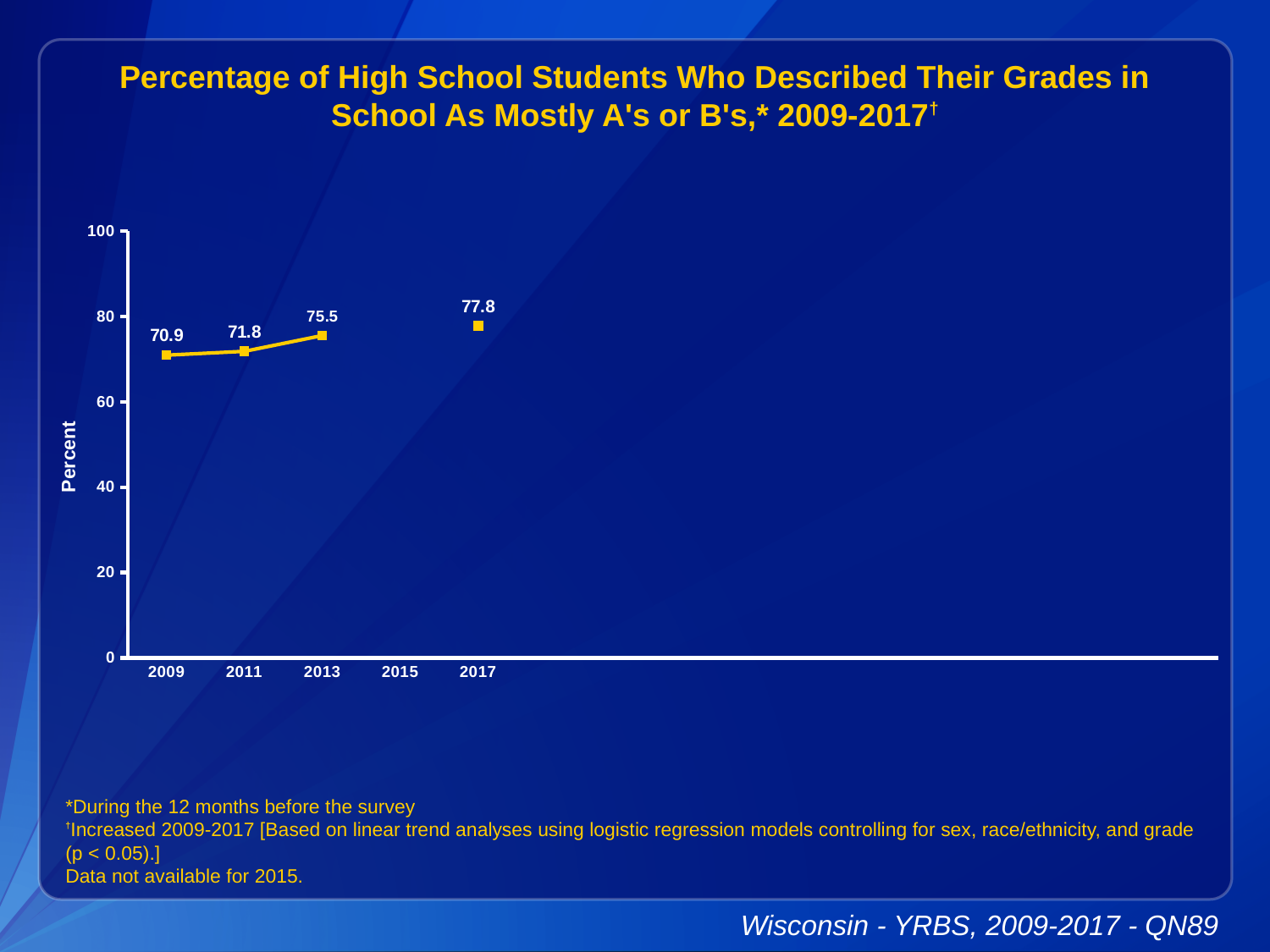
Is the value for 2017 greater or less than 80? less Which is larger, the value for 2011 or the value for 2013? 2013 Which year has the highest value? 2017 What is the value for 2013? 75.5 What is the value for 2009? 70.9 Which year has the lowest value? 2009 Do the values rise or fall from 2009 to 2017? rise What is the label on the vertical axis? Percent How many years have a plotted data point? 4 What is the value for 2017? 77.8 What kind of chart is shown? line chart What is the difference between the values for 2017 and 2009? 6.9